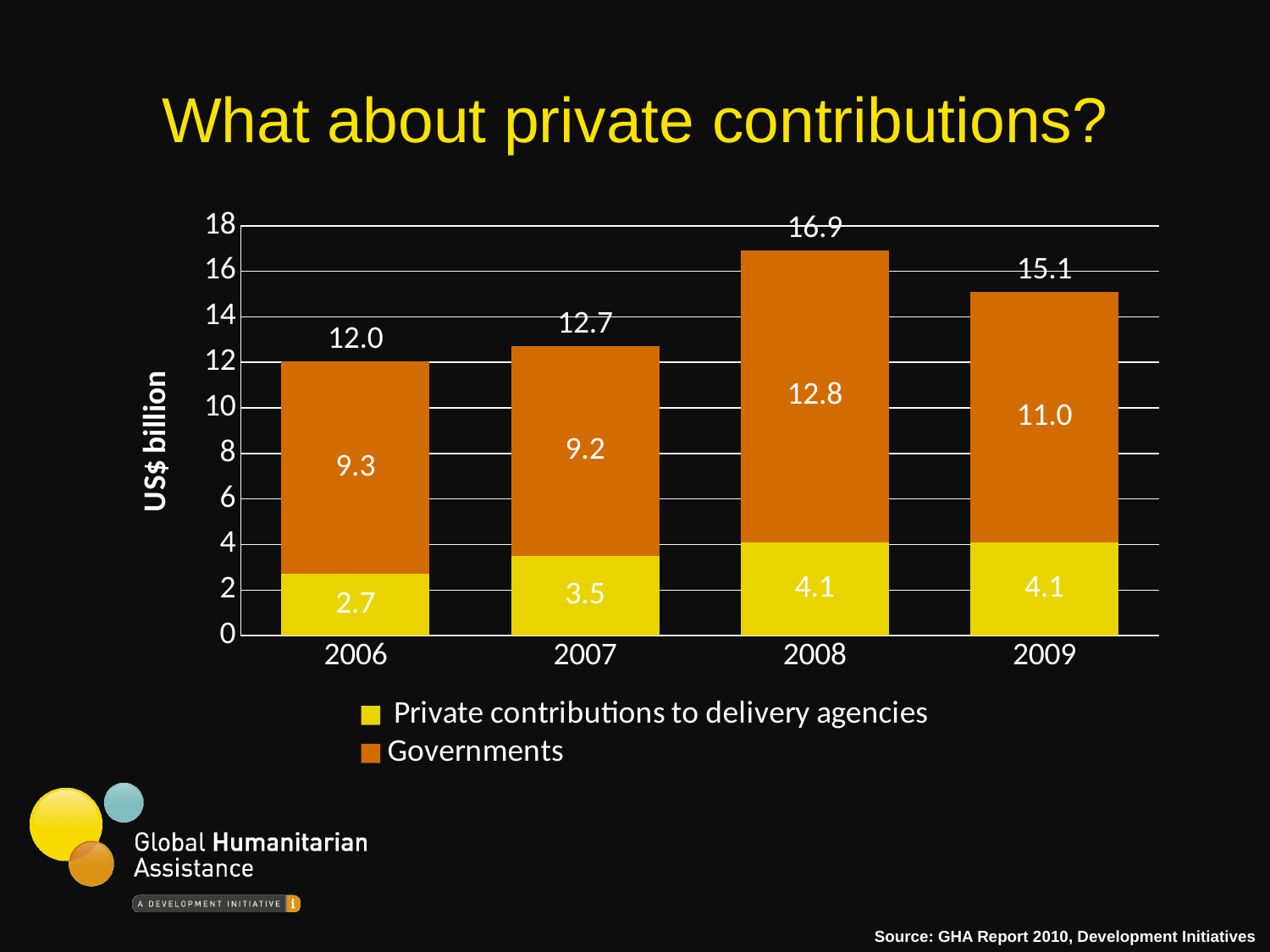
What kind of chart is shown? Stacked bar chart Do the Private contributions to delivery agencies values rise or fall from 2006 to 2008? Rise How many series does the legend list? 2 What is the value for Private contributions to delivery agencies in 2006? 2.7 What is the value for Governments in 2008? 12.8 Which year has the lowest value for Private contributions to delivery agencies? 2006 What is the total of the stacked bar for 2009? 15.1 Which is larger, the Governments value in 2006 or in 2007? 2006 What is the label on the y axis? US$ billion What is the difference between the Governments values for 2008 and 2009? 1.8 Which year has the highest total? 2008 How many years are shown on the x axis? 4